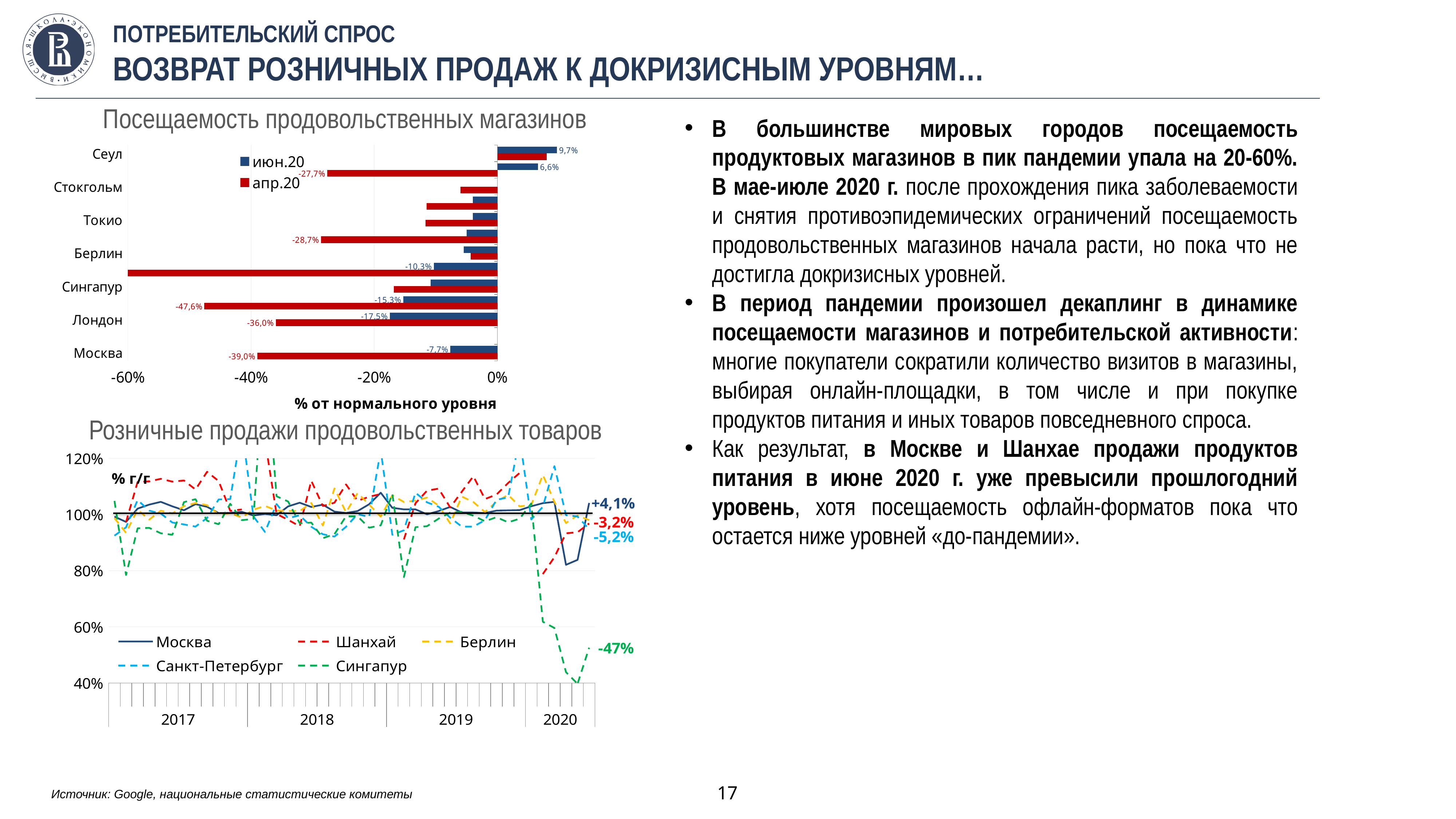
In the 'Розничные продажи продовольственных товаров' chart, what is the end-of-series label shown for Москва? +4,1% In the 'Посещаемость продовольственных магазинов' chart, what is the difference between the апр.20 and июн.20 values for Москва? 31,3 percentage points How many series does the legend of the 'Розничные продажи продовольственных товаров' chart list? 5 What kind of chart is the 'Розничные продажи продовольственных товаров' chart? line chart In the 'Посещаемость продовольственных магазинов' chart, which is higher for июн.20: Москва or Лондон? Москва In the 'Посещаемость продовольственных магазинов' chart, what is the апр.20 value for Москва? -39,0% In the 'Посещаемость продовольственных магазинов' chart, what is the апр.20 value for Лондон? -36,0% What kind of chart is the 'Посещаемость продовольственных магазинов' chart? bar chart In the 'Посещаемость продовольственных магазинов' chart, what is the июн.20 value for Москва? -7,7% In the 'Посещаемость продовольственных магазинов' chart, what is the июн.20 value for Сеул? 9,7% How many series does the legend of the 'Посещаемость продовольственных магазинов' chart list? 2 In the 'Розничные продажи продовольственных товаров' chart, what is the end-of-series label shown for Сингапур? -47%